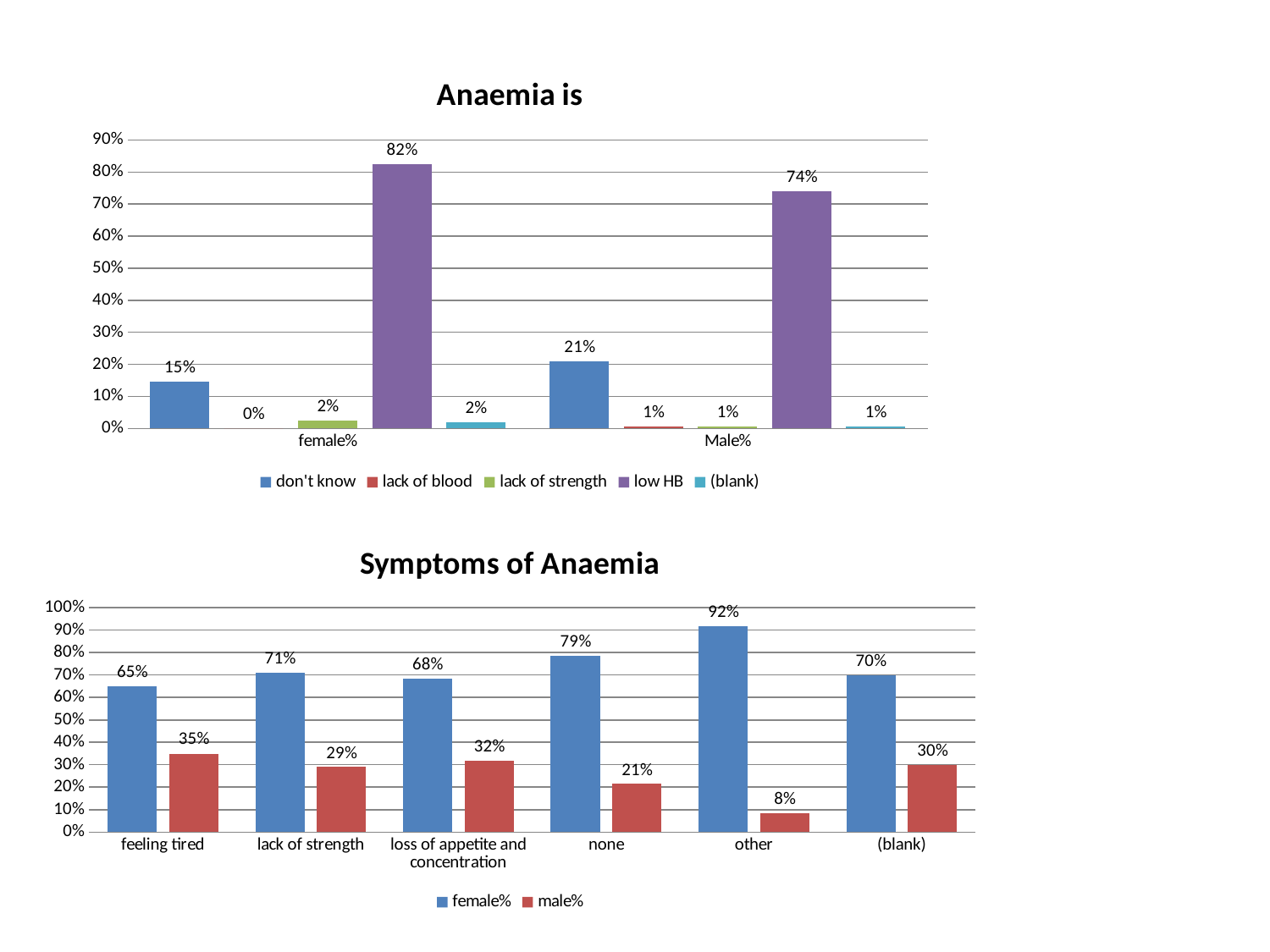
In the 'Symptoms of Anaemia' chart, how many categories are shown on the x axis? 6 In the 'Symptoms of Anaemia' chart, what is the difference between the female% and male% values for 'feeling tired'? 30% In the 'Anaemia is' chart, how many series does the legend list? 5 In the 'Anaemia is' chart, what is the value for 'don't know' in the Male% group? 21% In the 'Symptoms of Anaemia' chart, which category has the lowest male% value? other In the 'Anaemia is' chart, what is the value for 'low HB' in the female% group? 82% In the 'Anaemia is' chart, which series has the highest value in the Male% group? low HB In the 'Anaemia is' chart, what is the value for 'lack of blood' in the female% group? 0% In the 'Symptoms of Anaemia' chart, which category has the highest female% value? other In the 'Anaemia is' chart, what is the difference between the 'low HB' values for female% and Male%? 8% What kind of chart is the 'Symptoms of Anaemia' chart? bar chart In the 'Symptoms of Anaemia' chart, what is the female% value for 'none'? 79%